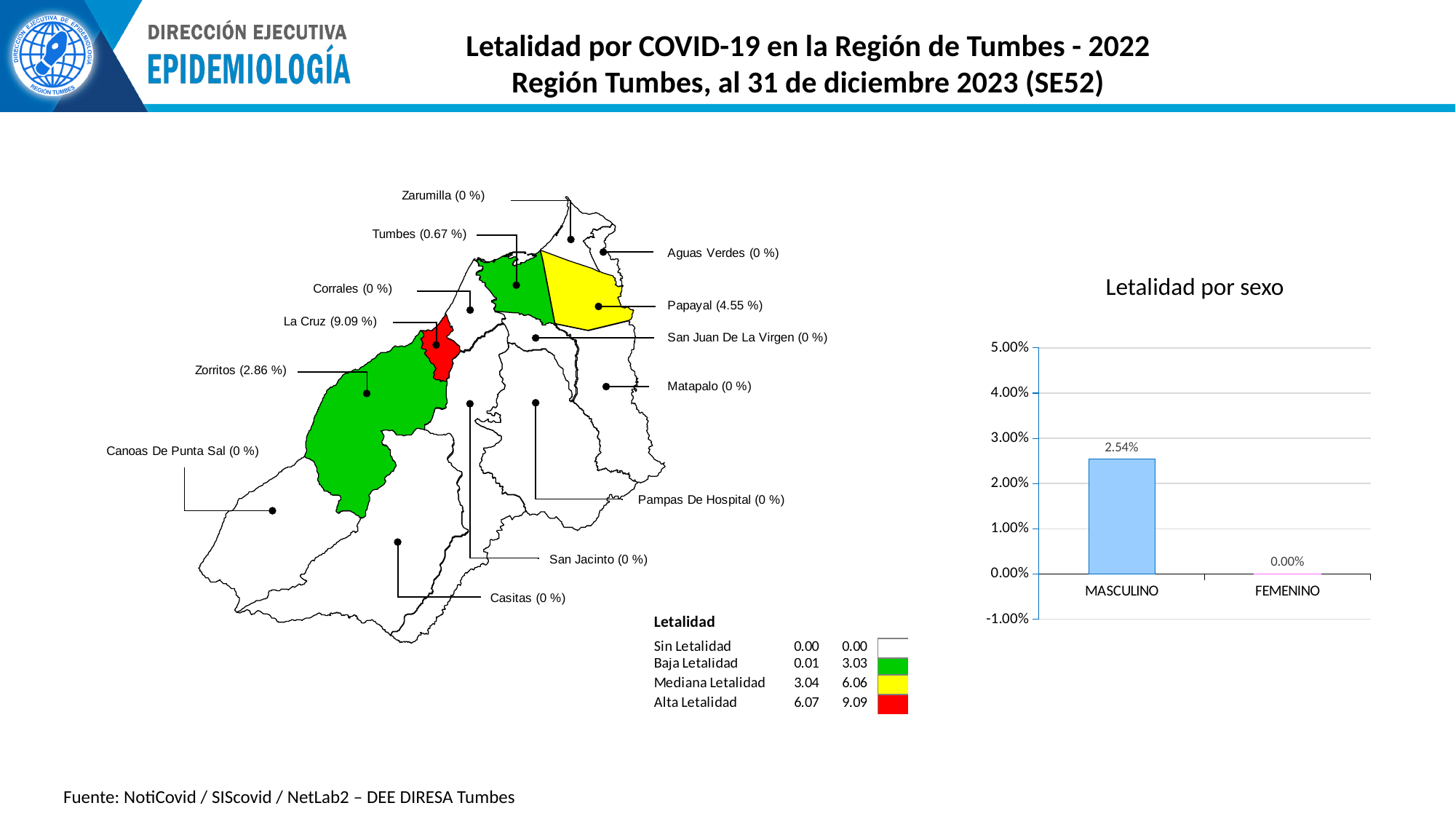
In the 'Letalidad por sexo' chart, what is the difference between the MASCULINO and FEMENINO values? 2.54% On the map, which is larger: the lethality value for Zorritos or for Tumbes? Zorritos On the map, which district has the highest lethality value? La Cruz (9.09 %) In the 'Letalidad por sexo' chart, which category has the lowest value? FEMENINO On the map, what is the lethality value shown for Papayal? 4.55 % In the 'Letalidad por sexo' chart, is the value for MASCULINO greater or less than 3.00%? less What is the title of the chart on the right side of the slide? Letalidad por sexo In the 'Letalidad por sexo' chart, what is the value for FEMENINO? 0.00% In the 'Letalidad por sexo' chart, what is the value for MASCULINO? 2.54% In the 'Letalidad por sexo' chart, which category has the highest value? MASCULINO What kind of chart is 'Letalidad por sexo'? bar chart How many categories are shown in the 'Letalidad por sexo' chart? 2